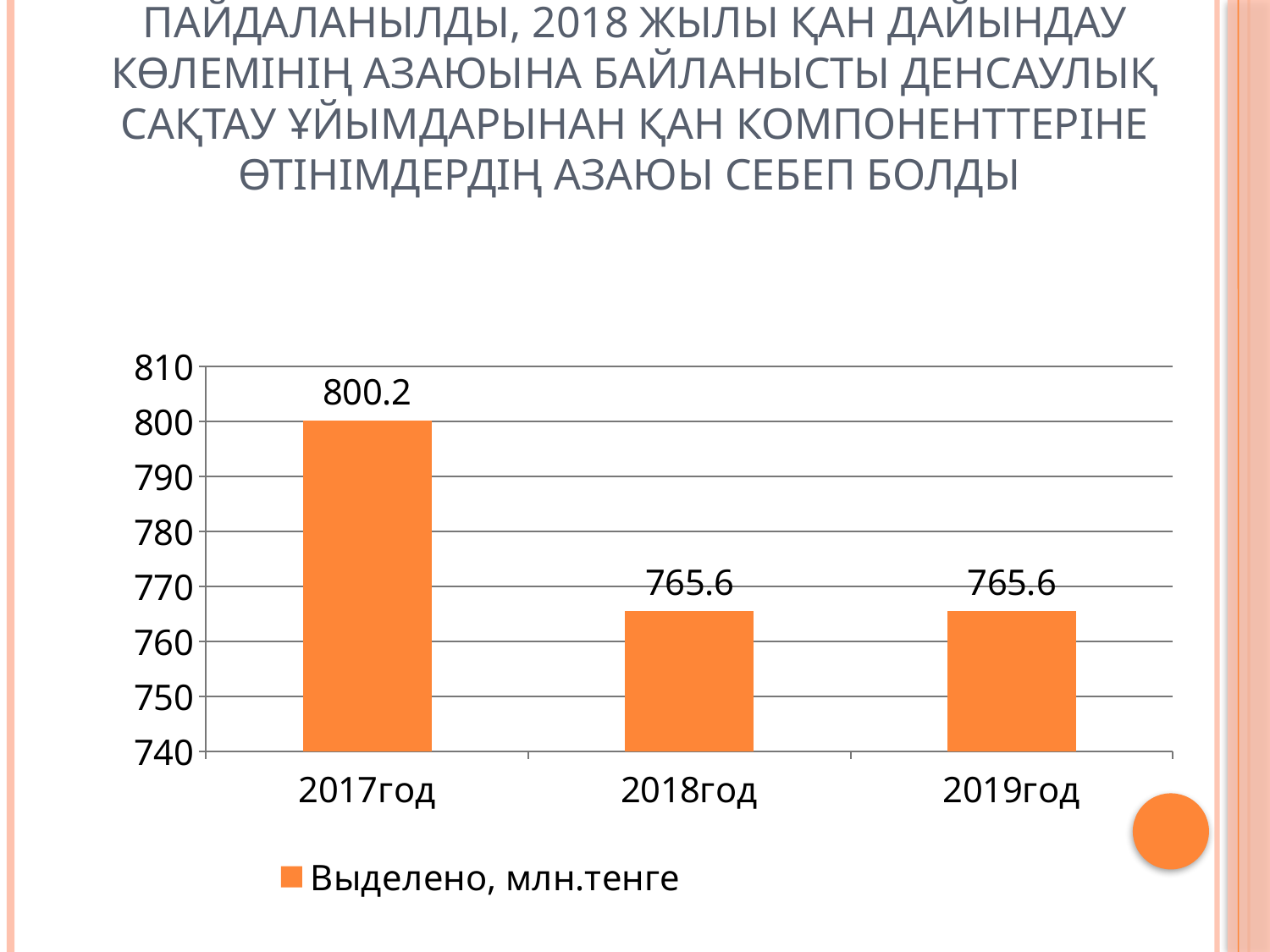
Is the value for 2018год greater or less than 770? less Which is larger, the value for 2017год or the value for 2019год? 2017год What is the legend entry for the series? Выделено, млн.тенге How many categories are shown on the x axis? 3 What is the value for 2019год? 765.6 What is the value for 2017год? 800.2 What is the value for 2018год? 765.6 What kind of chart is shown on the slide? bar chart What is the difference between the values for 2017год and 2018год? 34.6 How many series does the legend list? 1 Is the value for 2017год greater or less than 790? greater Which year has the highest value? 2017год